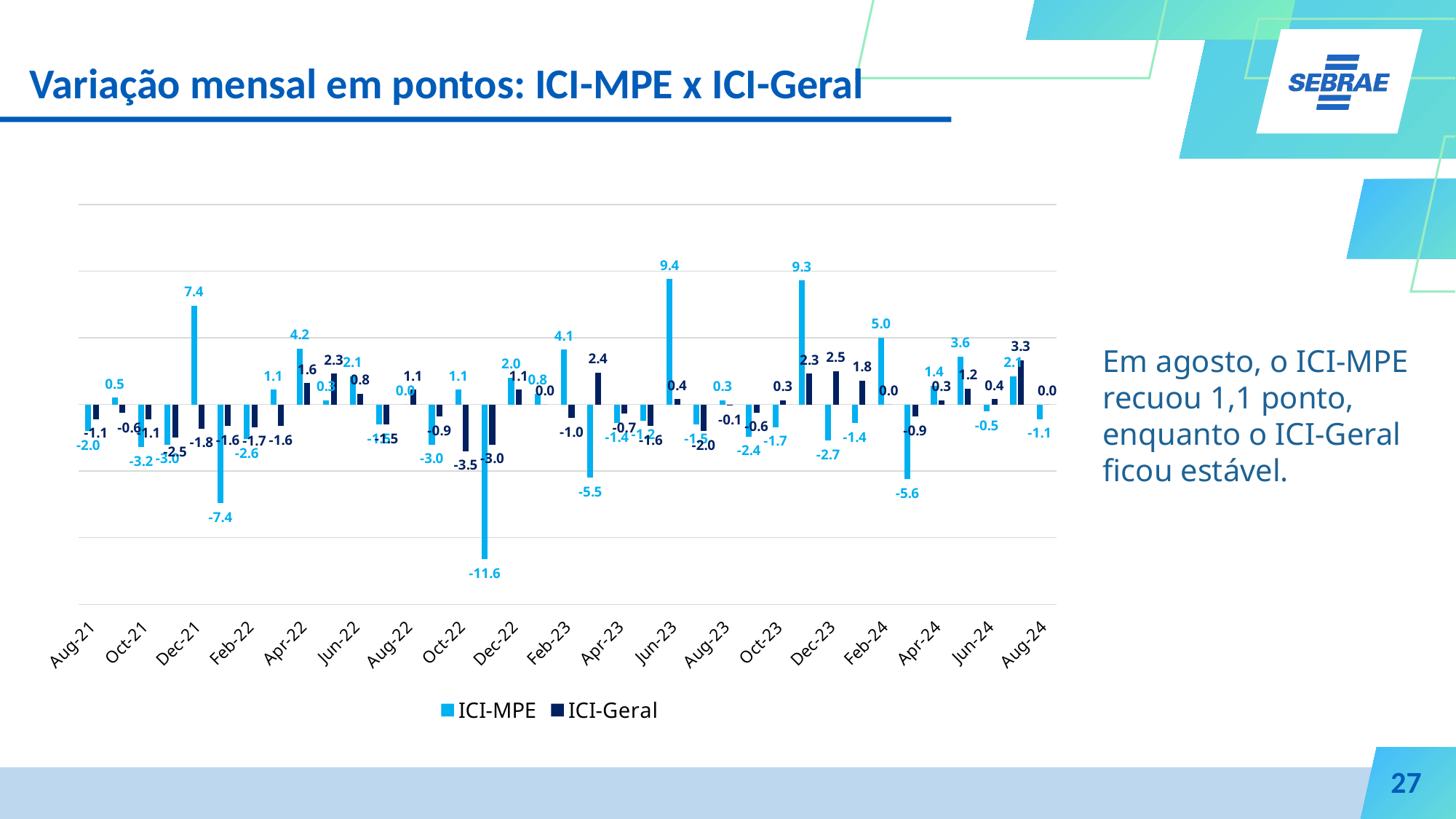
What is the ICI-Geral value for Oct-22? -3.5 What is the title of the chart? Variação mensal em pontos: ICI-MPE x ICI-Geral What kind of chart is shown on the slide? bar chart What is the ICI-MPE value for Dec-21? 7.4 What is the highest ICI-Geral value shown on the chart? 3.3 What is the ICI-Geral value for Aug-24? 0.0 In which labelled month does ICI-MPE reach its highest value? Jun-23 What is the lowest ICI-MPE value shown on the chart? -11.6 How many series does the legend list? 2 What is the ICI-MPE value for Aug-24? -1.1 Which series has the larger value in Jun-23, ICI-MPE or ICI-Geral? ICI-MPE What is the difference between the ICI-MPE and ICI-Geral values in Feb-24? 5.0